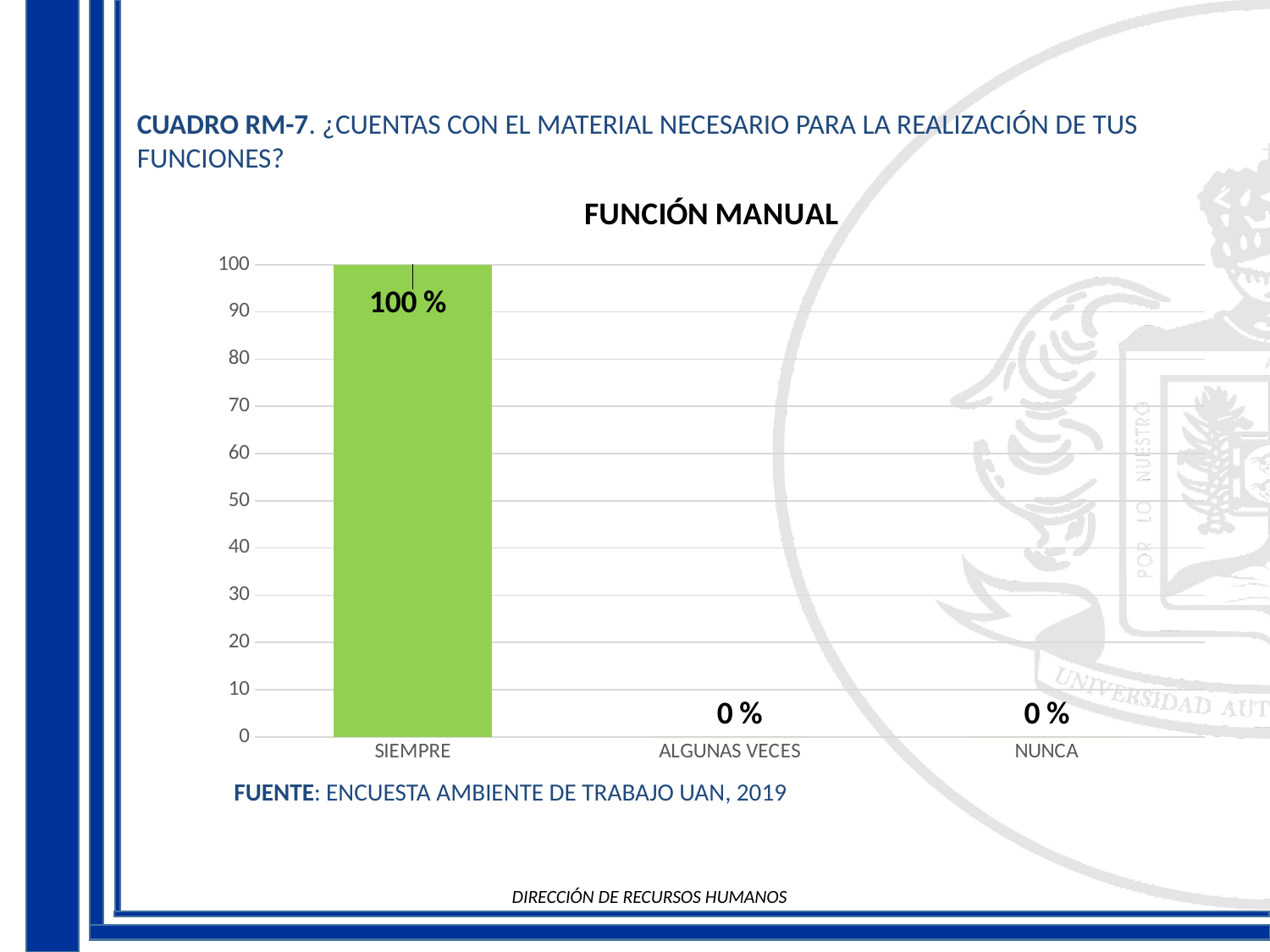
What is the title of the chart? FUNCIÓN MANUAL What colour is the bar for SIEMPRE? green What is the difference between the values for SIEMPRE and NUNCA? 100 % What is the value for SIEMPRE? 100 % Which is larger, the value for SIEMPRE or the value for ALGUNAS VECES? SIEMPRE Which category has the highest value? SIEMPRE Is the value for SIEMPRE greater or less than 50? greater What kind of chart is shown? bar chart What is the highest tick value shown on the y axis? 100 What is the value for ALGUNAS VECES? 0 % How many categories are shown on the x axis? 3 What is the value for NUNCA? 0 %